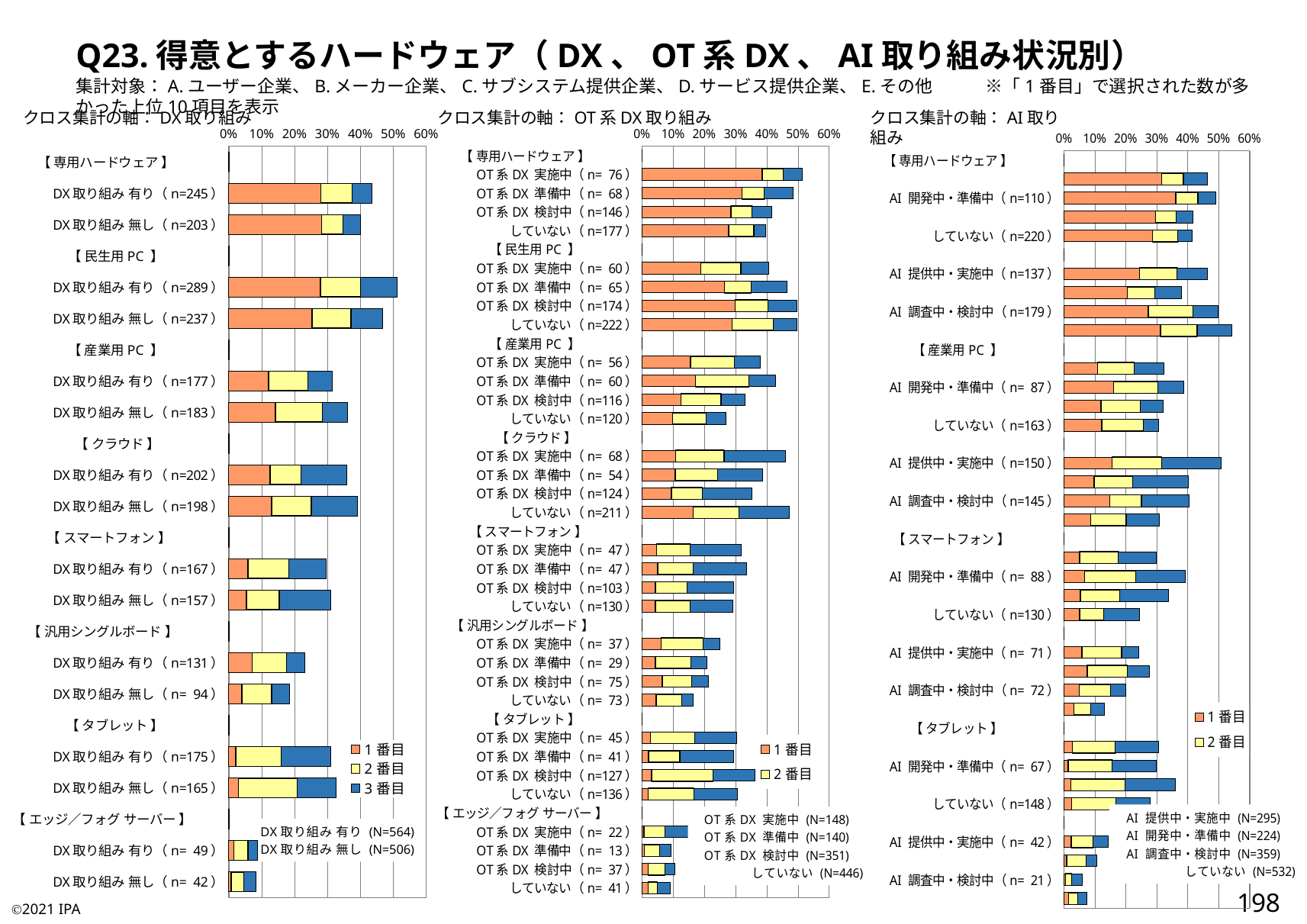
What is the N value printed for DX取り組み 有り in the note on the left chart? N=564 In the middle chart (クロス集計の軸：OT系DX取り組み), is the total bar for 民生用PC していない (n=222) greater or less than 40%? greater In the middle chart (クロス集計の軸：OT系DX取り組み), which total bar is longer: クラウド OT系DX 実施中 (n=68) or 汎用シングルボード OT系DX 実施中 (n=37)? クラウド OT系DX 実施中 (n=68) How many series does the legend of the left chart (クロス集計の軸：DX取り組み) list? 3 How many series does the legend of the middle chart (クロス集計の軸：OT系DX取り組み) list? 2 In the left chart (クロス集計の軸：DX取り組み), which total bar is longer: 民生用PC DX取り組み 有り (n=289) or 産業用PC DX取り組み 有り (n=177)? 民生用PC DX取り組み 有り (n=289) In the middle chart (クロス集計の軸：OT系DX取り組み), is the total bar for エッジ／フォグ サーバー OT系DX 実施中 (n=22) greater or less than 20%? less In the left chart (クロス集計の軸：DX取り組み), is the total bar for 民生用PC DX取り組み 有り (n=289) greater or less than 40%? greater What is the title of the slide containing the three charts? Q23. 得意とするハードウェア（DX、OT系DX、AI取り組み状況別） What is the maximum value shown on the x axis of the left chart (クロス集計の軸：DX取り組み)? 60% What type of chart is the left chart (クロス集計の軸：DX取り組み)? stacked bar chart